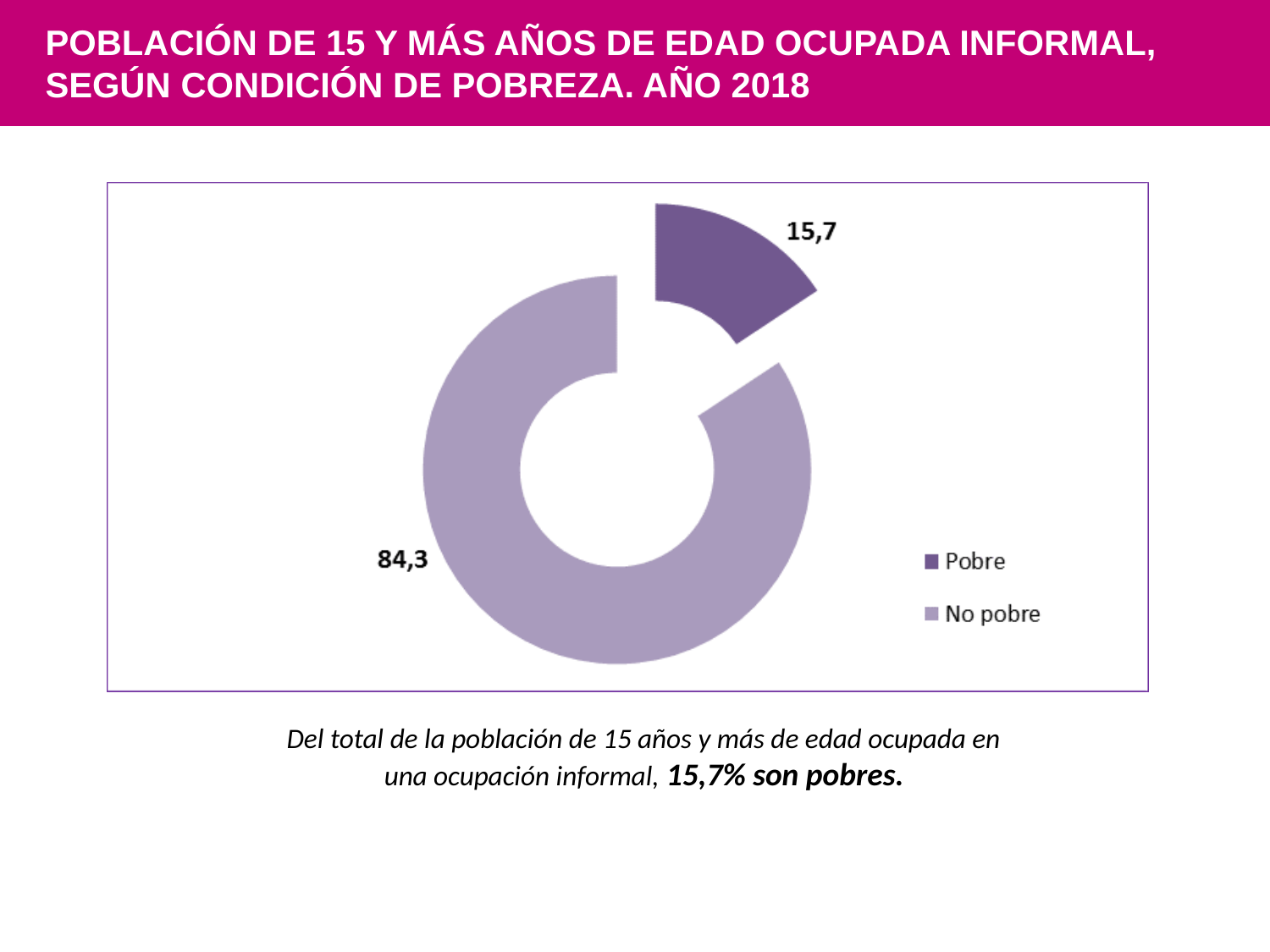
What year does the chart title refer to? 2018 What is the value shown for the Pobre slice? 15,7 Which legend entry is shown in the darker purple colour? Pobre What is the value shown for the No pobre slice? 84,3 Which category has the smallest slice? Pobre How many entries does the legend list? 2 How many categories does the chart show? 2 What is the difference between the No pobre value and the Pobre value? 68,6 Which is larger, the Pobre slice or the No pobre slice? No pobre What is the total of the two values shown on the chart? 100 What kind of chart is shown on the slide? Doughnut (pie) chart Which category has the largest slice? No pobre